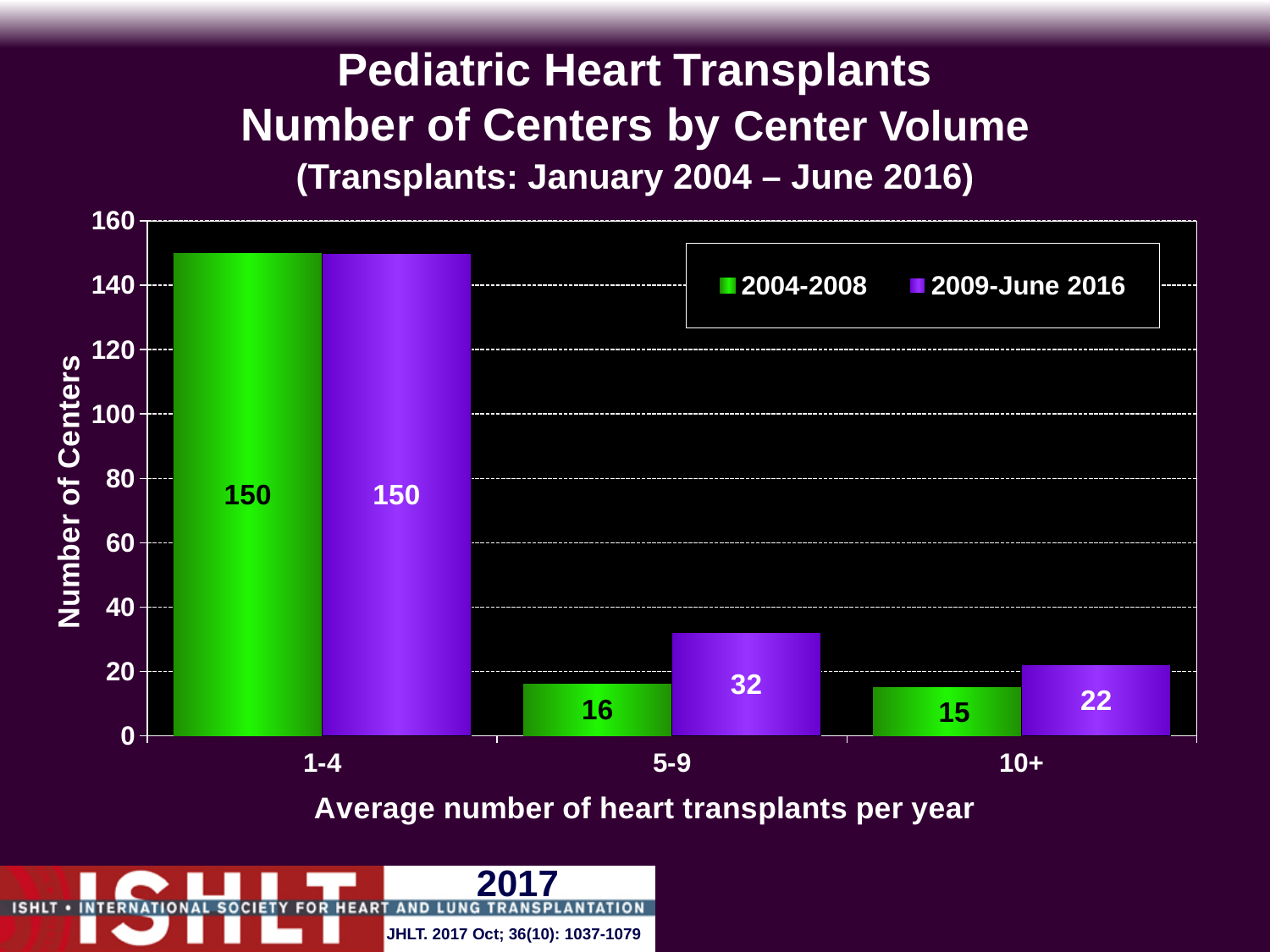
How many series does the legend list? 2 What is the number of centers for the 5-9 category in 2009-June 2016? 32 What is the number of centers for the 1-4 category in 2004-2008? 150 What is the difference between the 2009-June 2016 and 2004-2008 values for the 5-9 category? 16 Which category has the highest number of centers in the 2009-June 2016 series? 1-4 Is the value for the 5-9 category in 2009-June 2016 greater or less than 20? greater What kind of chart is shown on the slide? bar chart How many categories are shown on the x axis? 3 Which category has the lowest number of centers in the 2004-2008 series? 10+ What is the label of the y axis? Number of Centers What is the number of centers for the 10+ category in 2004-2008? 15 Which is larger for the 10+ category: the 2004-2008 value or the 2009-June 2016 value? 2009-June 2016